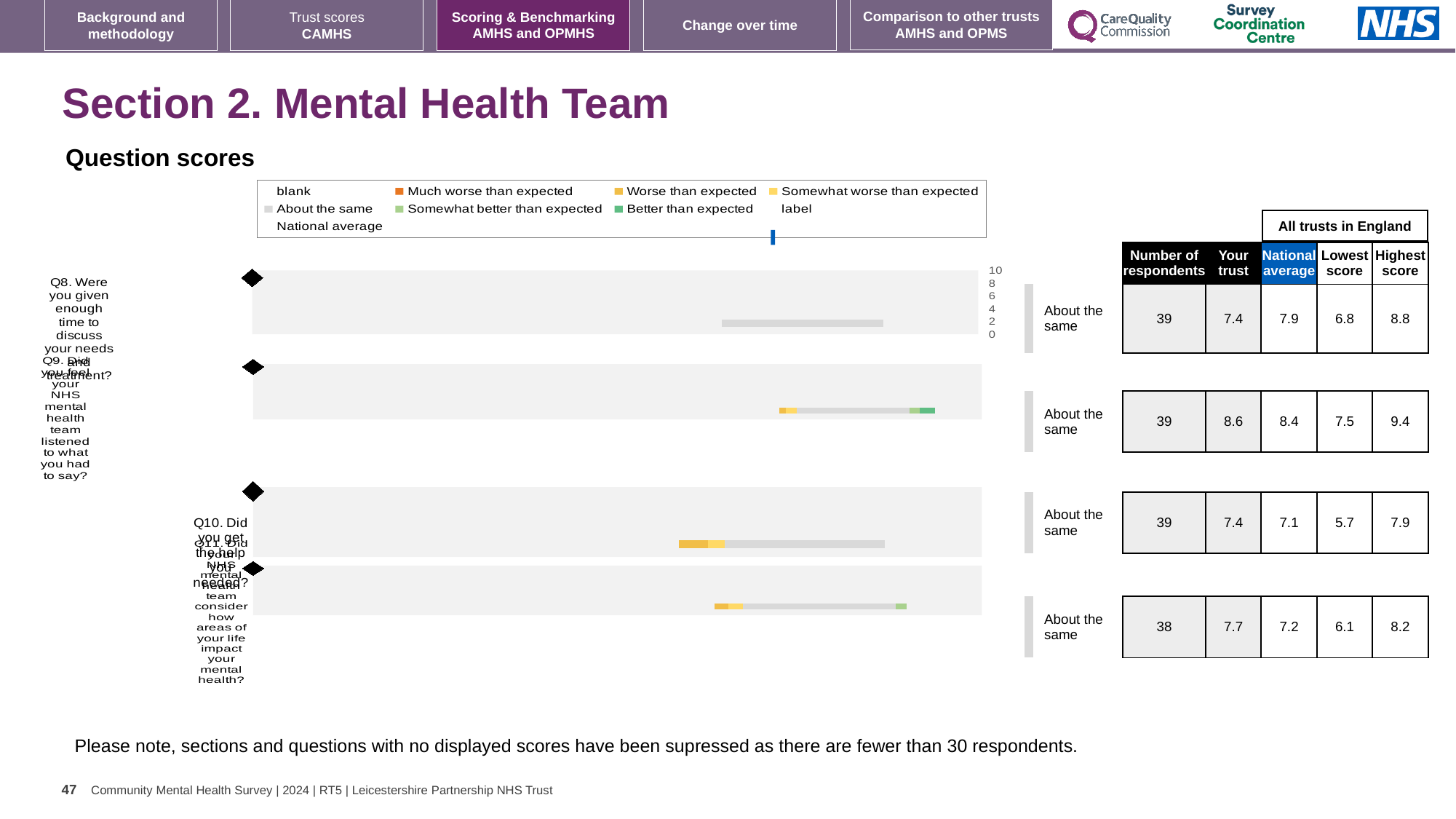
Which question has the highest 'Your trust' score? Q9 Which question has the lowest national average score? Q10 What is the national average score for Q9 (Did you feel your NHS mental health team listened to what you had to say)? 8.4 How many respondents answered Q11 (Did your NHS mental health team consider how areas of your life impact your mental health)? 38 For Q8, which is larger: the 'Your trust' score or the national average? National average What benchmark category is shown for Q10 in the Question scores chart? About the same What kind of chart is used to show the question scores? bar chart What is the difference between the 'Your trust' score and the national average for Q9? 0.2 What is the 'Your trust' score for Q8 (Were you given enough time to discuss your needs and treatment)? 7.4 What is the lowest score among all trusts in England for Q10 (Did you get the help you needed)? 5.7 What is the difference between the highest score and the lowest score for Q8? 2.0 How many questions are plotted in the Question scores chart? 4